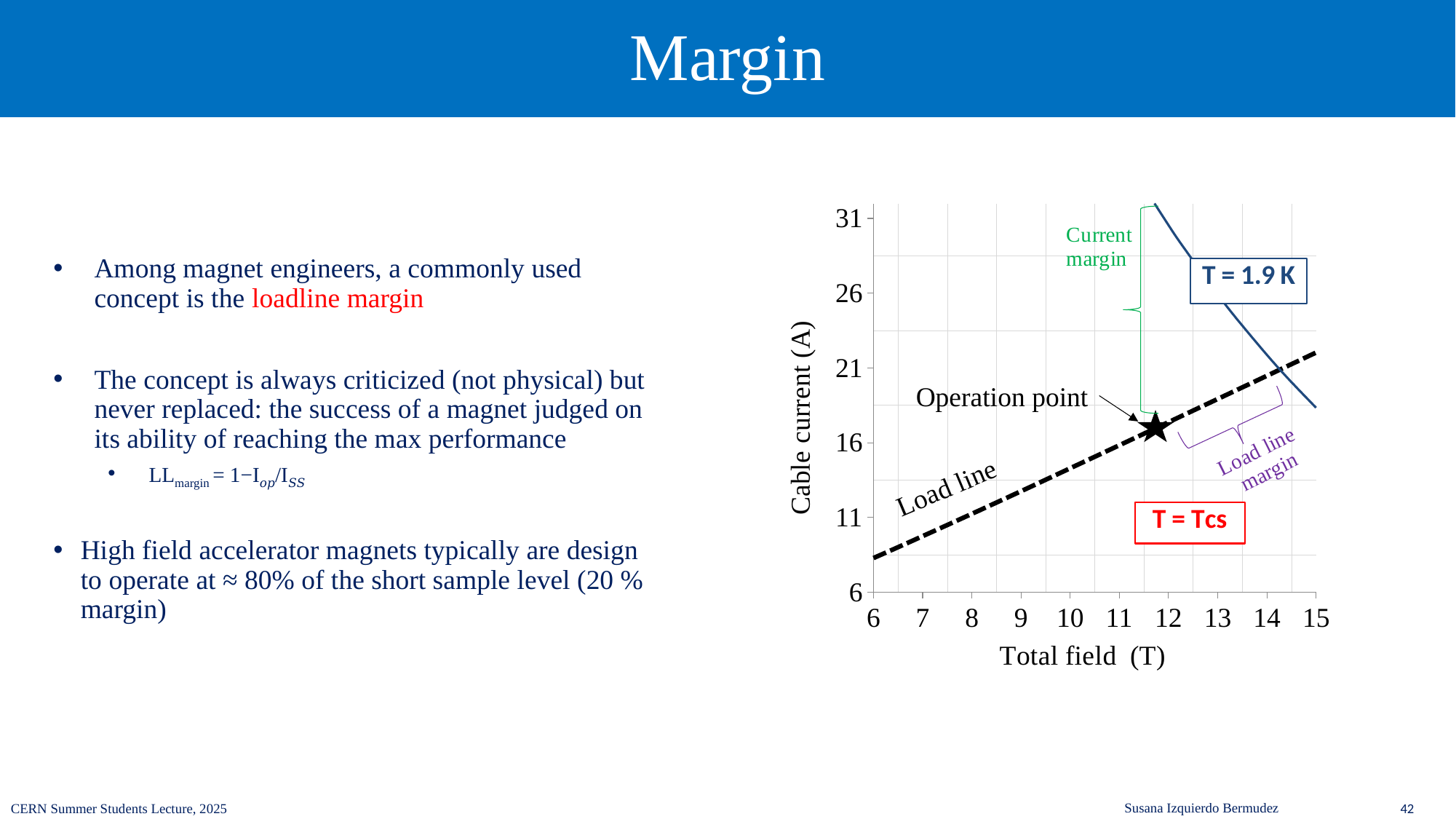
At a total field of 12 T, which is higher: the load line or the T = 1.9 K curve? T = 1.9 K curve Is the cable current at the operation point greater or less than 11 A? greater Does the load line rise or fall as the total field increases? rises Is the cable current at the operation point greater or less than 21 A? less What kind of chart is shown on the slide? line chart Is the total field where the load line crosses the T = 1.9 K curve greater or less than 13 T? greater What is the label of the y axis of the chart? Cable current (A) What is the label of the x axis of the chart? Total field (T) How many tick labels are shown on the x axis of the chart? 10 Does the T = 1.9 K curve rise or fall as the total field increases? falls